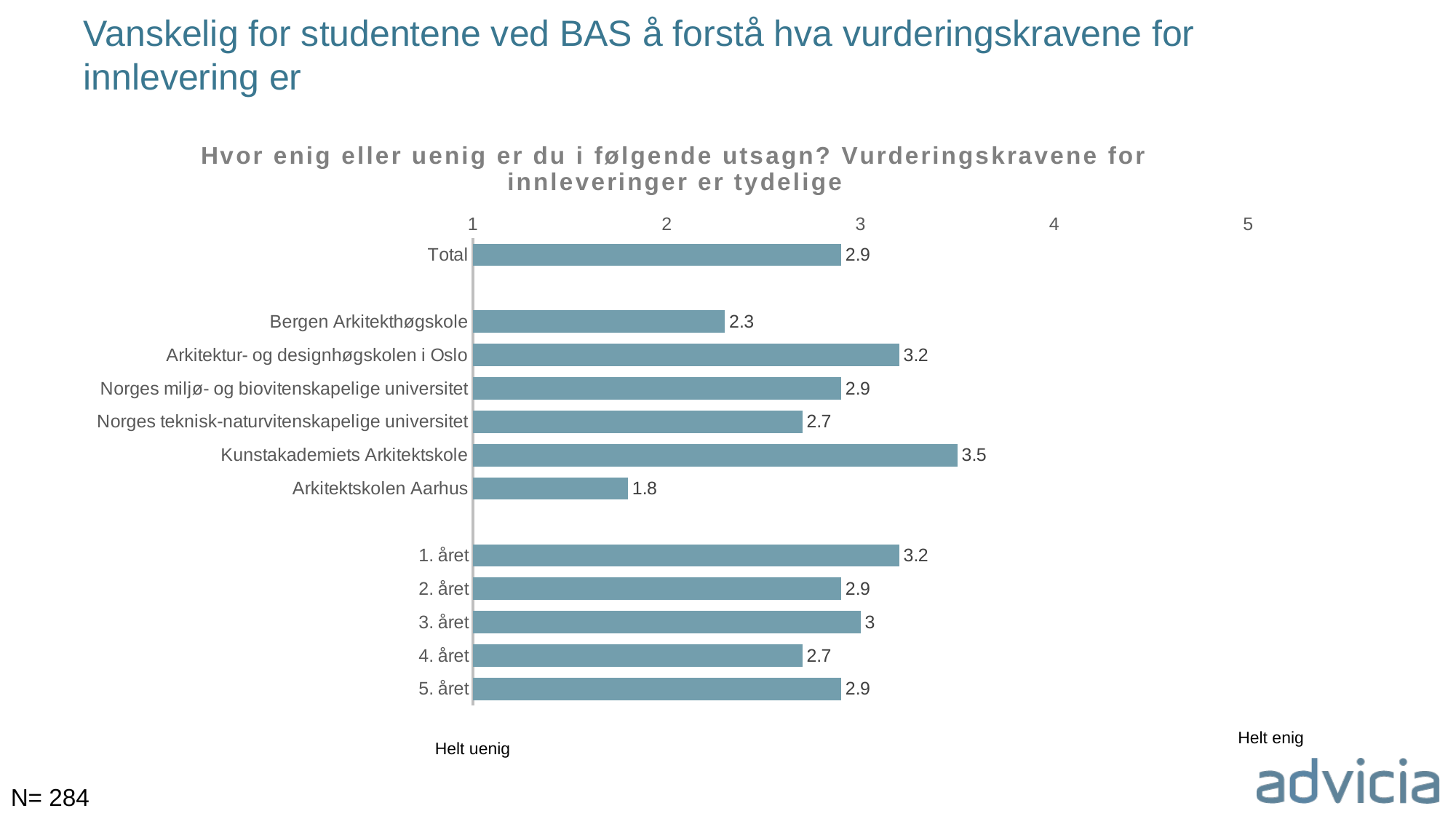
What is the difference between the values for Kunstakademiets Arkitektskole and Arkitektskolen Aarhus? 1.7 What label appears at the left end of the scale below the chart? Helt uenig Which category has the highest value? Kunstakademiets Arkitektskole What is the value for Total? 2.9 What kind of chart is shown on the slide? bar chart Which category has the lowest value? Arkitektskolen Aarhus What is the value for Bergen Arkitekthøgskole? 2.3 Is the value for Arkitektur- og designhøgskolen i Oslo greater or less than 3? greater How many bars are plotted in the chart? 12 What is the value for Kunstakademiets Arkitektskole? 3.5 Which is larger, the value for 1. året or the value for 4. året? 1. året What is the value for 3. året? 3